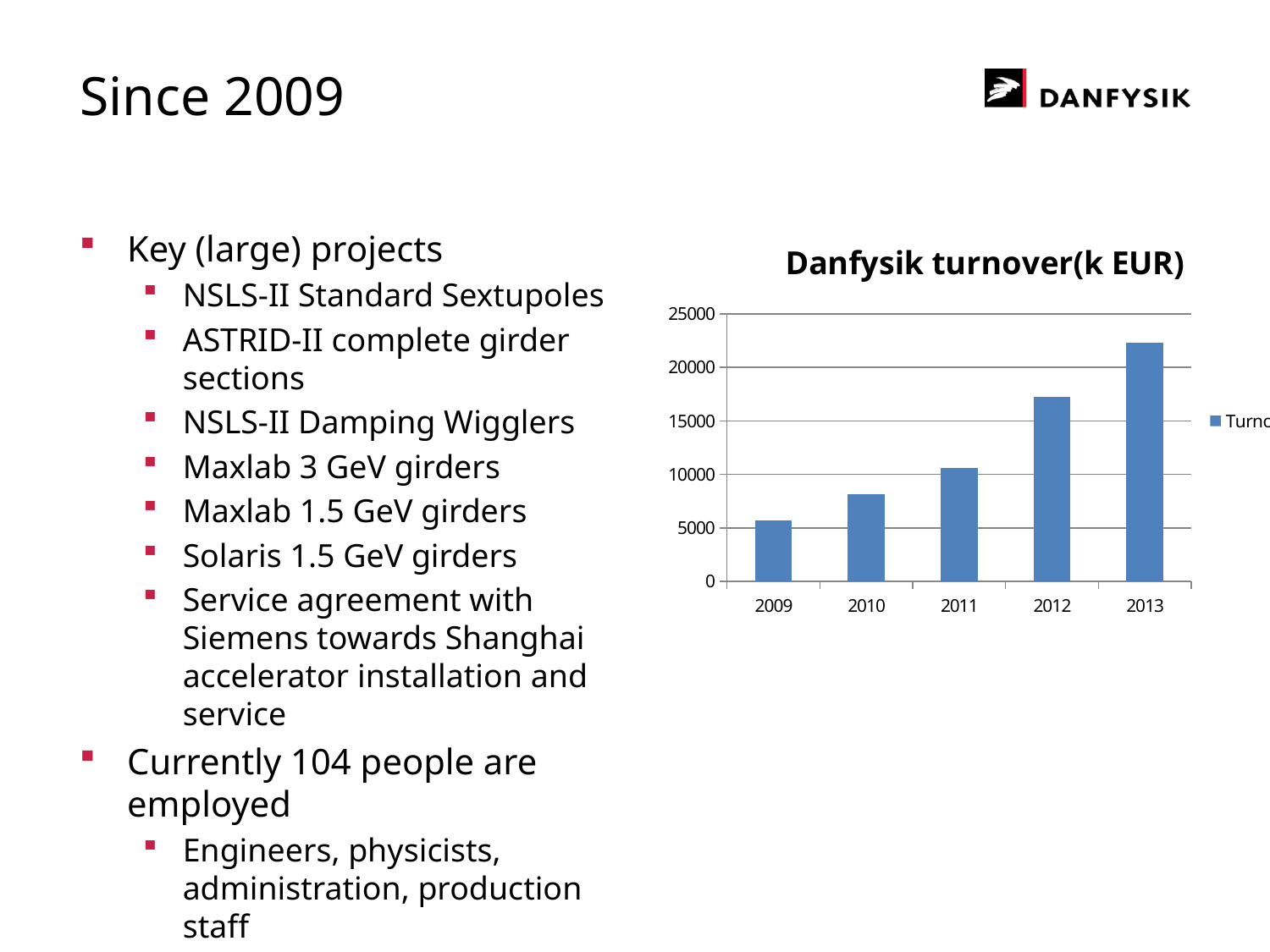
What kind of chart is shown on the slide? bar chart Is the turnover for 2012 greater or less than 15000? greater Is the turnover for 2009 greater or less than 10000? less What is the title of the chart? Danfysik turnover(k EUR) How many years are shown on the x axis of the chart? 5 How many series does the chart's legend list? 1 Which year has the larger turnover, 2011 or 2012? 2012 Which year has the highest turnover in the chart? 2013 Is the turnover for 2010 greater or less than 10000? less Which year has the lowest turnover in the chart? 2009 Do the turnover values rise or fall from 2009 to 2013? rise